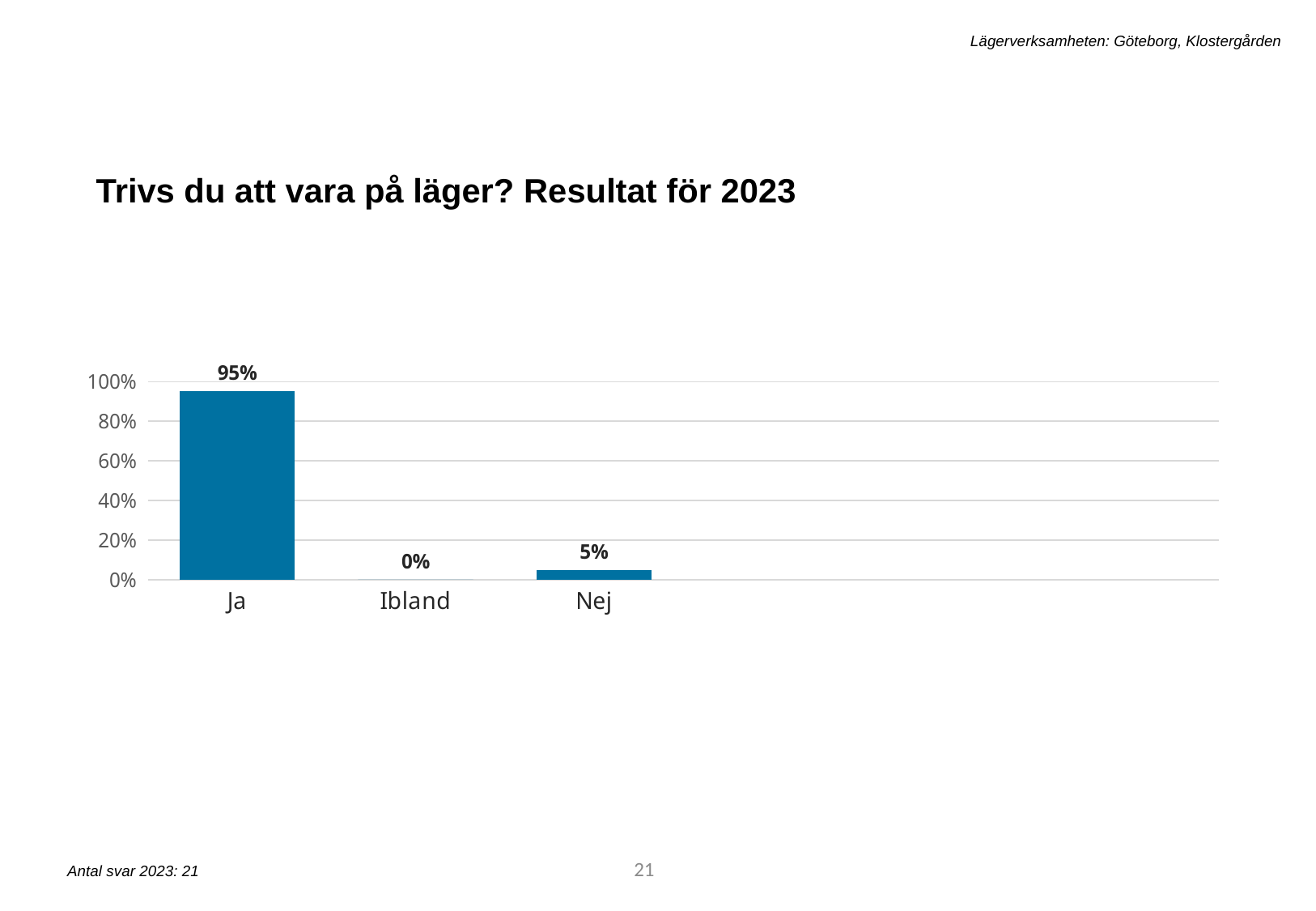
Is the value for Nej greater or less than 20%? less What is the value for Ibland? 0% Which category has the highest value? Ja Which category has the lowest value? Ibland What kind of chart is shown on the slide? bar chart What is the value for Ja? 95% How many categories are shown on the x axis? 3 What is the difference between the values for Ja and Nej? 90% Is the value for Ja greater or less than 80%? greater What is the value for Nej? 5% Which is larger, the value for Nej or the value for Ibland? Nej What is the title of the slide above the chart? Trivs du att vara på läger? Resultat för 2023